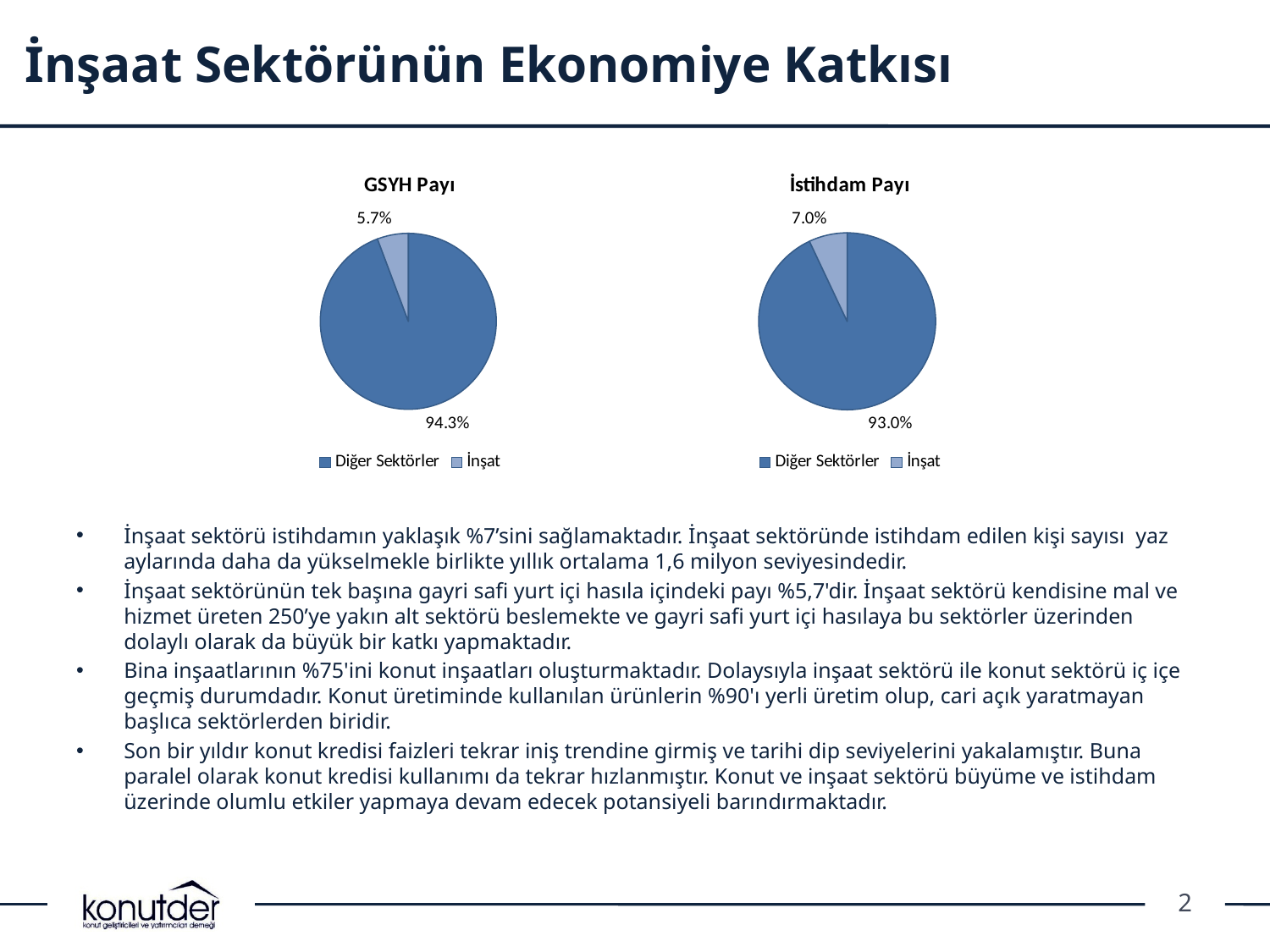
In the 'İstihdam Payı' chart, what is the difference between Diğer Sektörler and İnşat? 86.0% In the 'GSYH Payı' chart, which slice is the largest? Diğer Sektörler In the 'İstihdam Payı' chart, what is the value for Diğer Sektörler? 93.0% In the 'İstihdam Payı' chart, which slice is the smallest? İnşat How many slices does the 'İstihdam Payı' chart have? 2 What type of chart is the 'GSYH Payı' chart? Pie chart How many entries does the legend of the 'GSYH Payı' chart list? 2 What is the title of the pie chart on the right side of the slide? İstihdam Payı In the 'GSYH Payı' chart, what is the value for Diğer Sektörler? 94.3% In the 'İstihdam Payı' chart, what is the value for İnşat? 7.0% Which is larger: the İnşat share in the 'GSYH Payı' chart or the İnşat share in the 'İstihdam Payı' chart? İstihdam Payı In the 'GSYH Payı' chart, what is the value for İnşat? 5.7%